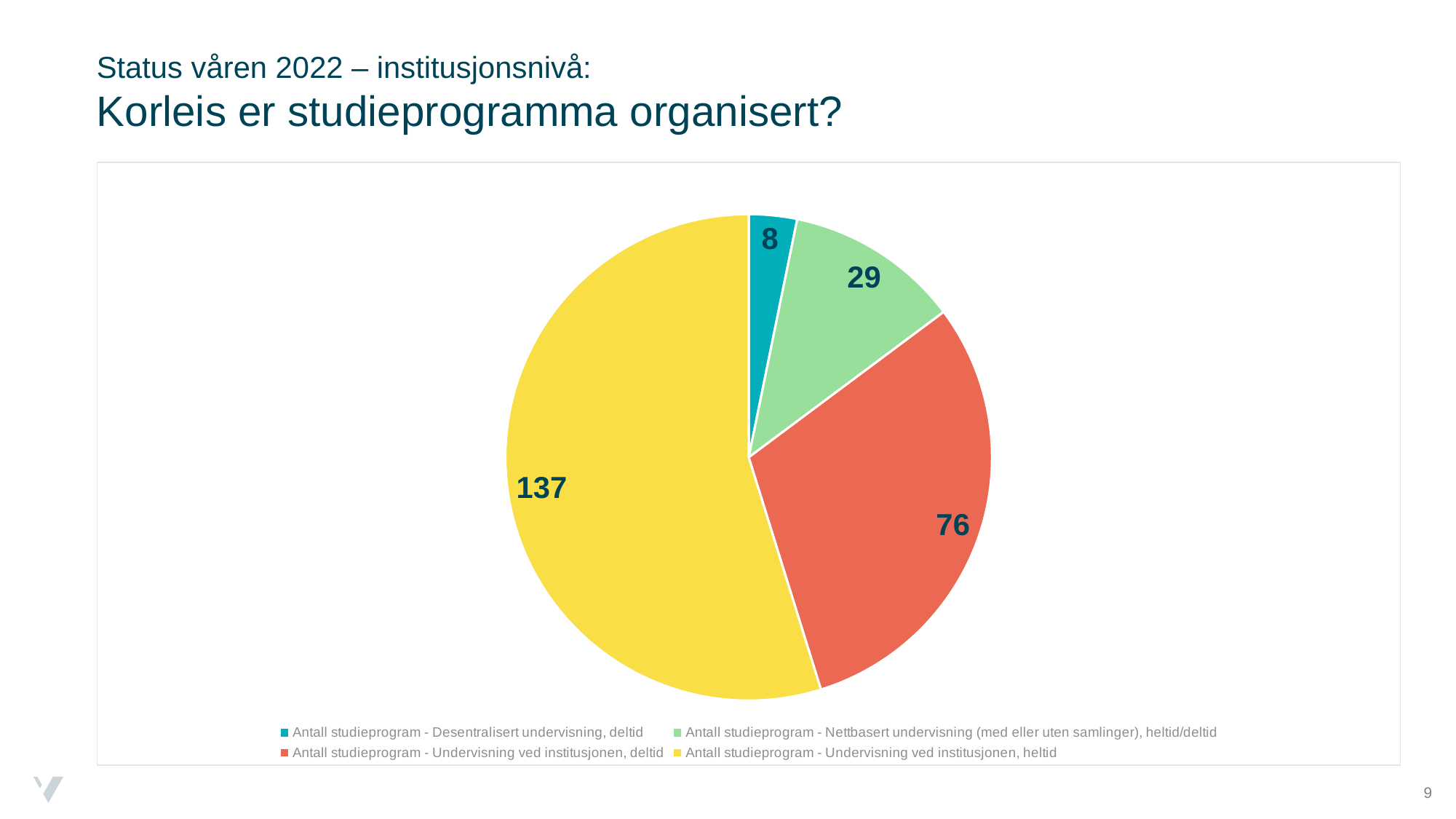
How many slices does the pie chart have? 4 What is the value for 'Antall studieprogram - Undervisning ved institusjonen, deltid'? 76 What is the total of all slices in the pie chart? 250 Which category has the smallest slice of the pie? Antall studieprogram - Desentralisert undervisning, deltid What is the value for 'Antall studieprogram - Desentralisert undervisning, deltid'? 8 What is the value for 'Antall studieprogram - Nettbasert undervisning (med eller uten samlinger), heltid/deltid'? 29 What colour is the slice for 'Antall studieprogram - Undervisning ved institusjonen, heltid'? Yellow Which category has the largest slice of the pie? Antall studieprogram - Undervisning ved institusjonen, heltid What kind of chart is shown on the slide? Pie chart Which is larger: the value for 'Nettbasert undervisning' or the value for 'Desentralisert undervisning, deltid'? Nettbasert undervisning What is the difference between the values for 'Undervisning ved institusjonen, heltid' and 'Undervisning ved institusjonen, deltid'? 61 What is the value for 'Antall studieprogram - Undervisning ved institusjonen, heltid'? 137